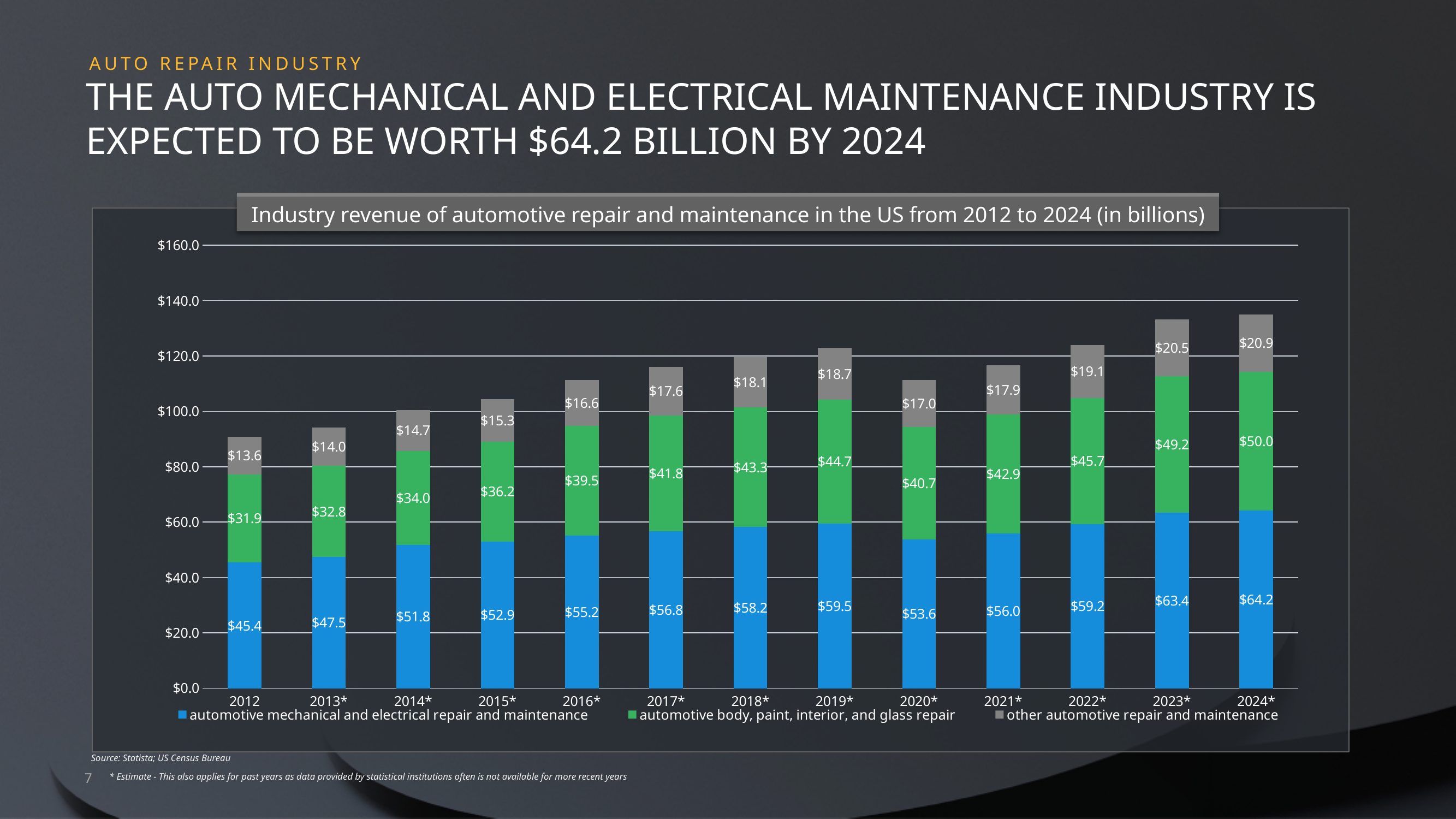
What is the value for automotive mechanical and electrical repair and maintenance in 2024*? $64.2 Which year has the lowest value for automotive mechanical and electrical repair and maintenance? 2012 How many years are shown on the x axis? 13 How many series does the legend list? 3 Is the total stacked bar for 2024* greater or less than $120.0? greater What is the total of the stacked bar for 2012? $90.9 What kind of chart is shown on the slide? stacked bar chart What is the value for other automotive repair and maintenance in 2012? $13.6 What is the value for automotive body, paint, interior, and glass repair in 2016*? $39.5 Which year has the highest value for automotive body, paint, interior, and glass repair? 2024* Which is larger, the automotive mechanical and electrical repair and maintenance value for 2019* or for 2020*? 2019* What is the difference between the automotive mechanical and electrical repair and maintenance values for 2024* and 2012? $18.8